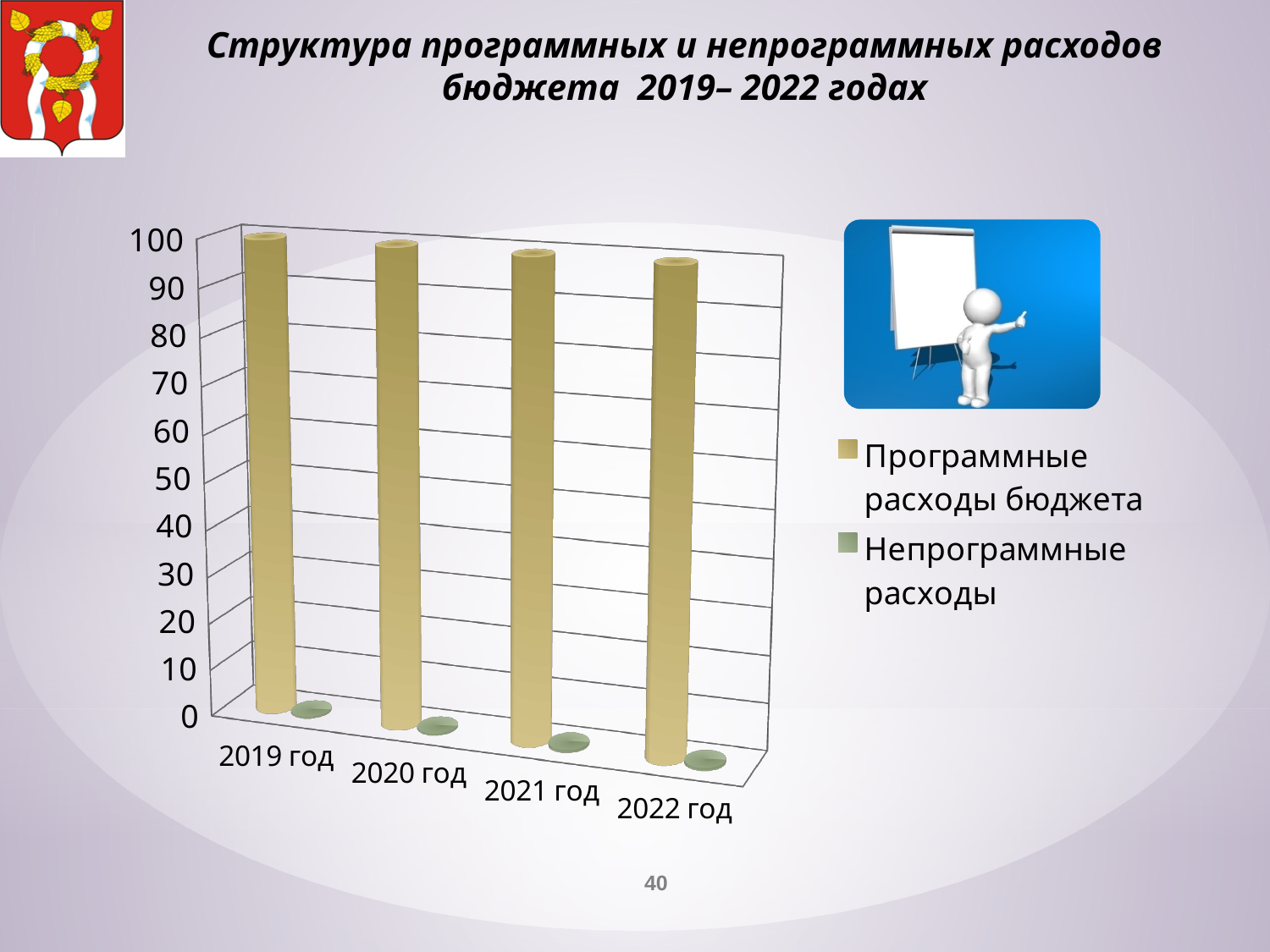
Do the values for Программные расходы бюджета rise or fall from 2019 год to 2022 год? fall What kind of chart is shown on the slide? bar chart In 2020 год, which is larger: Программные расходы бюджета or Непрограммные расходы? Программные расходы бюджета Is the value for Программные расходы бюджета in 2019 год greater or less than 90? greater How many series does the chart legend list? 2 How many years (categories) are shown on the x axis of the chart? 4 Which series is shown in green in the chart? Непрограммные расходы Is the value for Программные расходы бюджета in 2022 год greater or less than 80? greater What is the title of the slide containing the chart? Структура программных и непрограммных расходов бюджета 2019– 2022 годах Is the value for Непрограммные расходы in 2022 год greater or less than 10? less